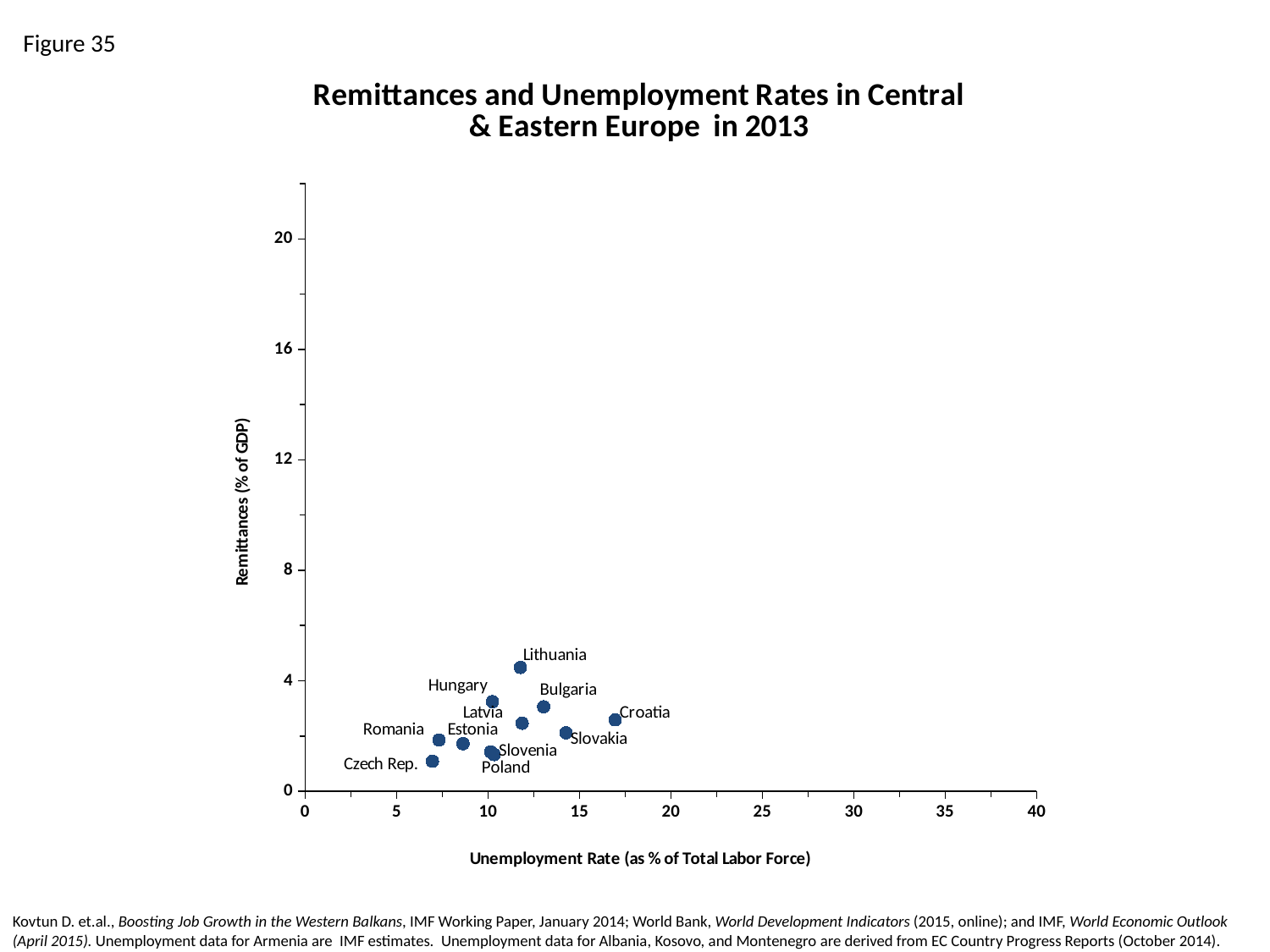
Which country has the highest remittances as a percentage of GDP? Lithuania Is the unemployment rate for Croatia greater or less than 15? greater Which country has the highest unemployment rate? Croatia Which country has the lowest remittances as a percentage of GDP? Czech Rep. Is the remittances value for Lithuania greater or less than 4? greater Is the unemployment rate for Czech Rep. greater or less than 10? less What kind of chart is shown on the slide? scatter chart How many countries are plotted on the chart? 11 Which has higher remittances as a percentage of GDP, Lithuania or Croatia? Lithuania What is the title of the x axis? Unemployment Rate (as % of Total Labor Force) Which has a higher unemployment rate, Croatia or Czech Rep.? Croatia